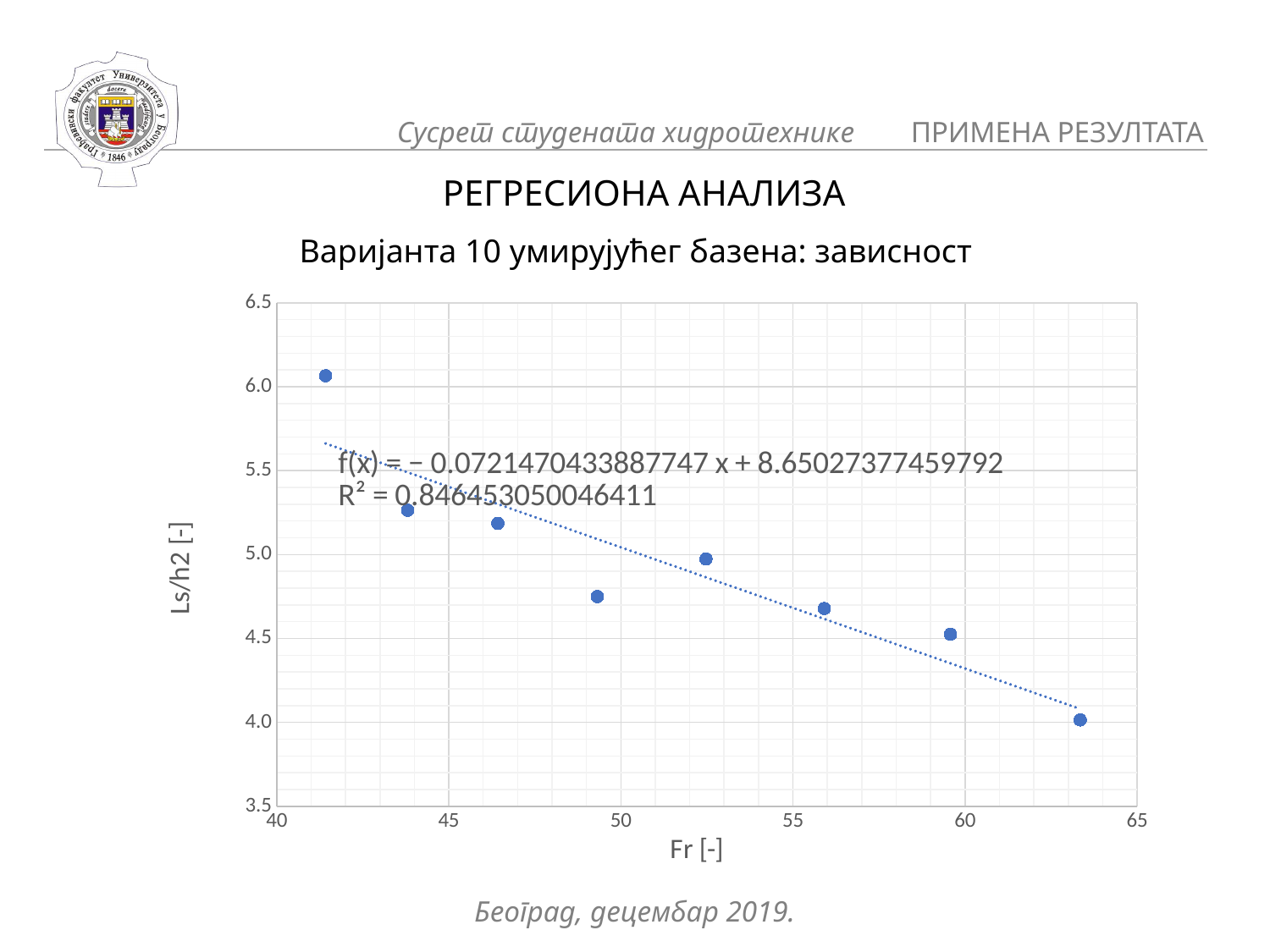
Is the Ls/h2 value for the point at Fr of about 56 greater or less than 5.0? less Do the Ls/h2 values generally rise or fall as Fr increases along the x axis? fall Is the Ls/h2 value for the point with the smallest Fr (around 41) greater or less than 5.5? greater What is the label of the x axis of the chart? Fr [-] Is the Ls/h2 value for the point at Fr of about 44 greater or less than 5.0? greater What R² value is printed on the chart? 0.846453050046411 Does the point with the highest Ls/h2 value have the smallest or the largest Fr value? smallest Which point has the higher Ls/h2 value: the one at Fr of about 52 or the one at Fr of about 60? the one at Fr of about 52 How many data points are plotted in the chart? 8 What kind of chart is shown on the slide? scatter chart